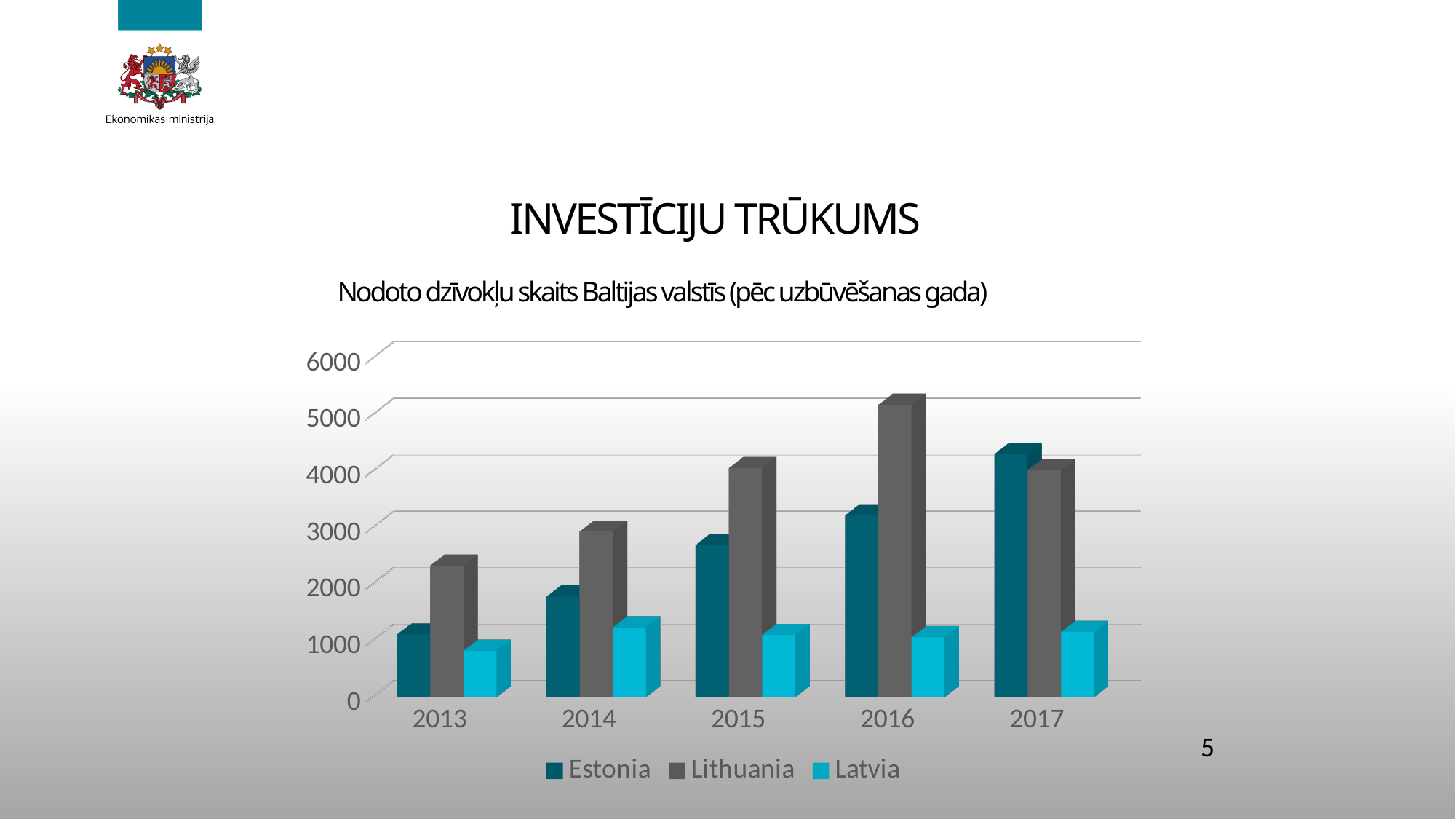
Which series has the highest bar in 2016? Lithuania Which series is shown in light blue in the legend? Latvia Which series has the lowest bar in 2013? Latvia Do the values for Estonia rise or fall from 2013 to 2017? rise What kind of chart is shown on the slide? bar chart In 2017, which is larger, the value for Estonia or the value for Lithuania? Estonia Is the value for Latvia in 2013 greater or less than 1000? less Is the value for Lithuania in 2016 greater or less than 4000? greater Is the value for Estonia in 2015 greater or less than 3000? less How many years are shown on the x axis? 5 How many series does the legend list? 3